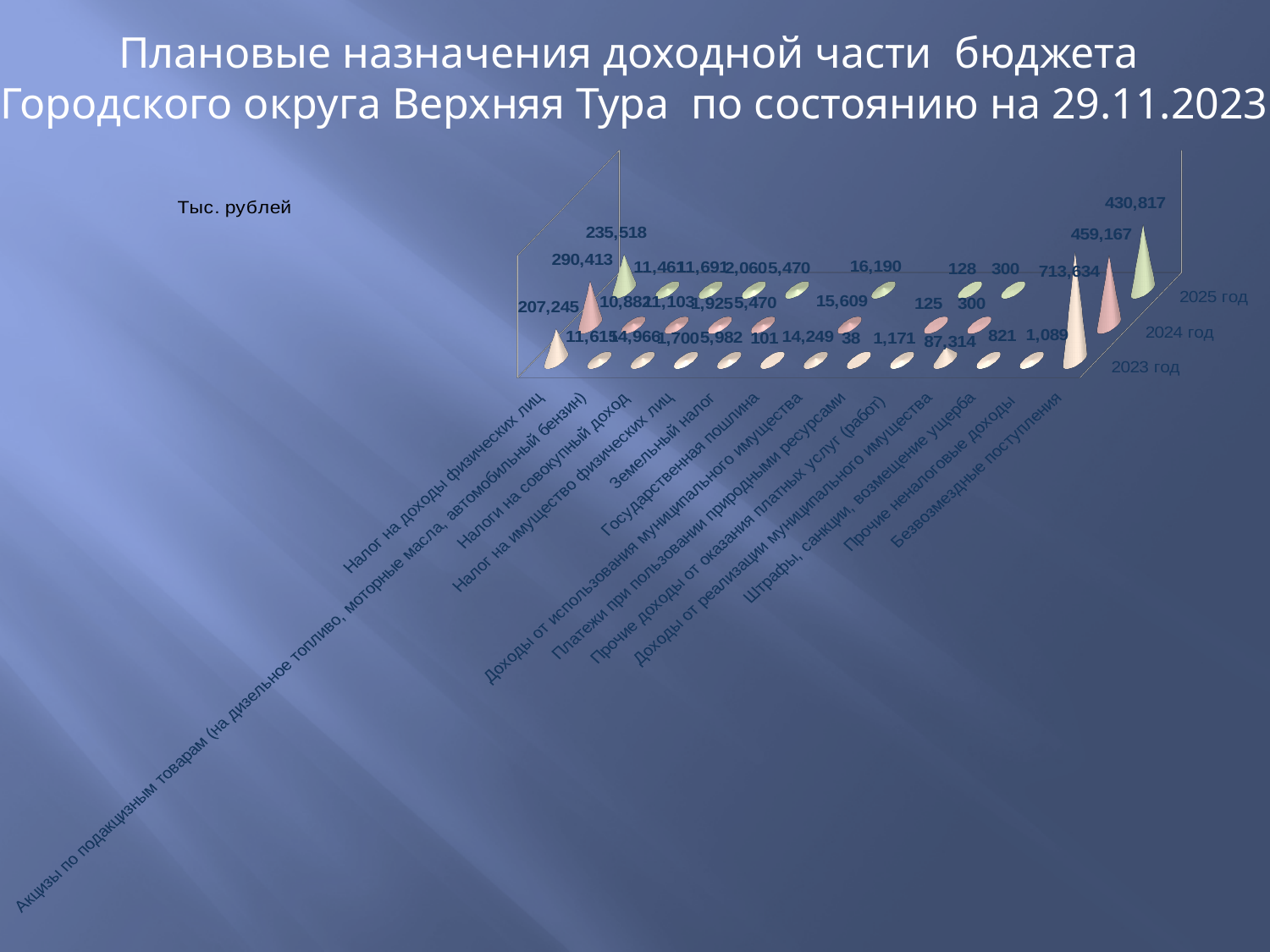
What is the planned value for Безвозмездные поступления in 2025 год? 430,817 How many years (series) are plotted on the chart? 3 For Налог на доходы физических лиц, which year has the larger value: 2024 год or 2025 год? 2024 год What is the difference between the 2024 год and 2023 год values for Налог на доходы физических лиц? 83,168 In what units are the chart values expressed, according to the label on the slide? Тыс. рублей How many revenue categories are shown along the x axis of the chart? 13 What is the planned value for Безвозмездные поступления in 2023 год? 713,634 What is the difference between the 2023 год and 2024 год values for Безвозмездные поступления? 254,467 What is the planned value for Налог на доходы физических лиц in 2024 год? 290,413 What is the planned value for Налог на доходы физических лиц in 2023 год? 207,245 What kind of chart is shown on the slide? bar chart Which category has the highest value in 2023 год? Безвозмездные поступления